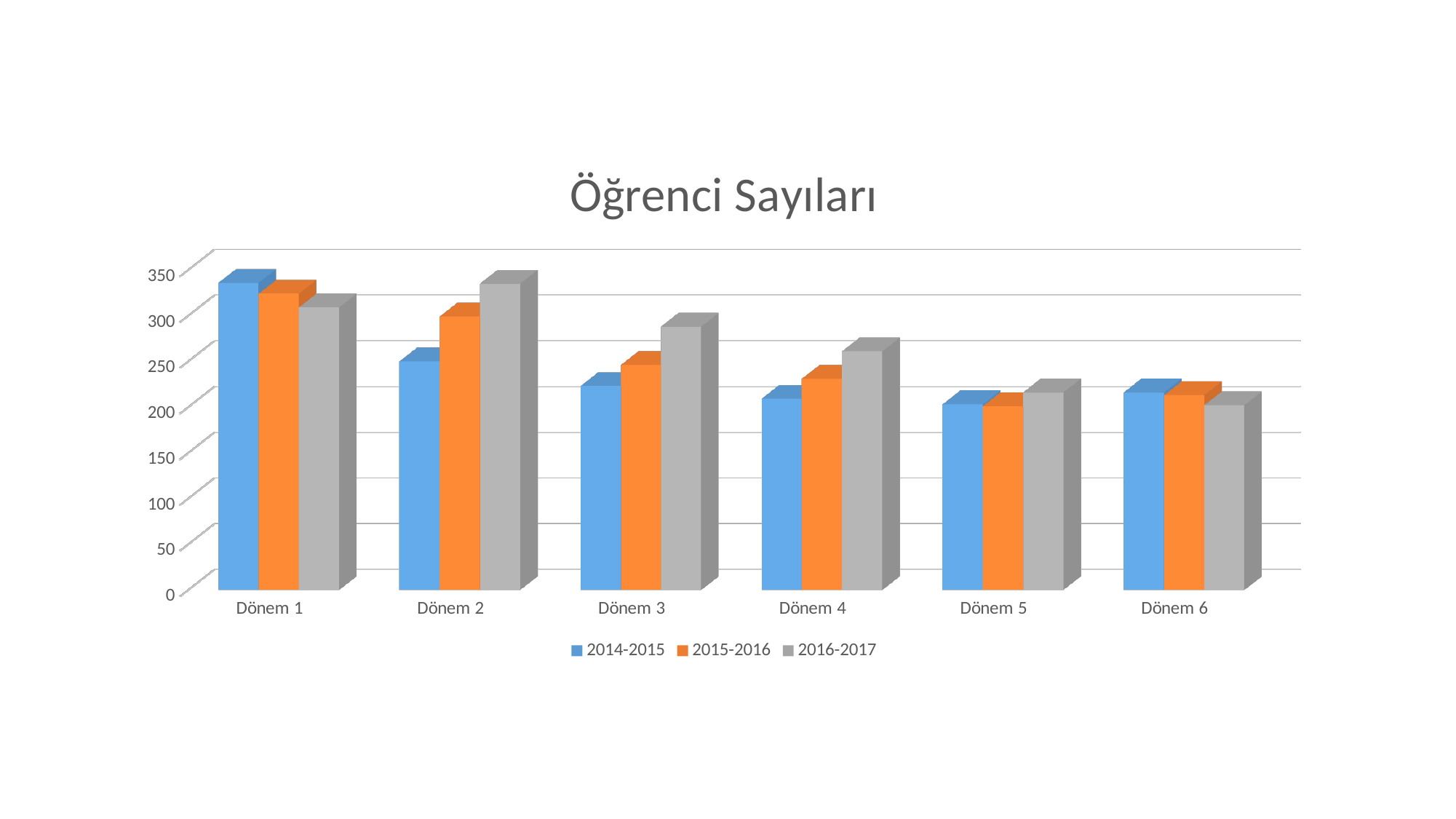
Is the value for 2014-2015 in Dönem 5 greater or less than 250? less Is the value for 2014-2015 in Dönem 1 greater or less than 300? greater What kind of chart is shown on the slide? bar chart Is the value for 2016-2017 in Dönem 3 greater or less than 250? greater For the 2016-2017 series, do the values rise or fall from Dönem 2 to Dönem 6? fall How many series does the legend list? 3 In Dönem 2, which is larger: the 2014-2015 value or the 2016-2017 value? 2016-2017 For the 2014-2015 series, which Dönem has the highest value? Dönem 1 What is the title of the chart? Öğrenci Sayıları Which colour represents the 2015-2016 series in the legend? orange How many categories (Dönem) are shown on the x axis? 6